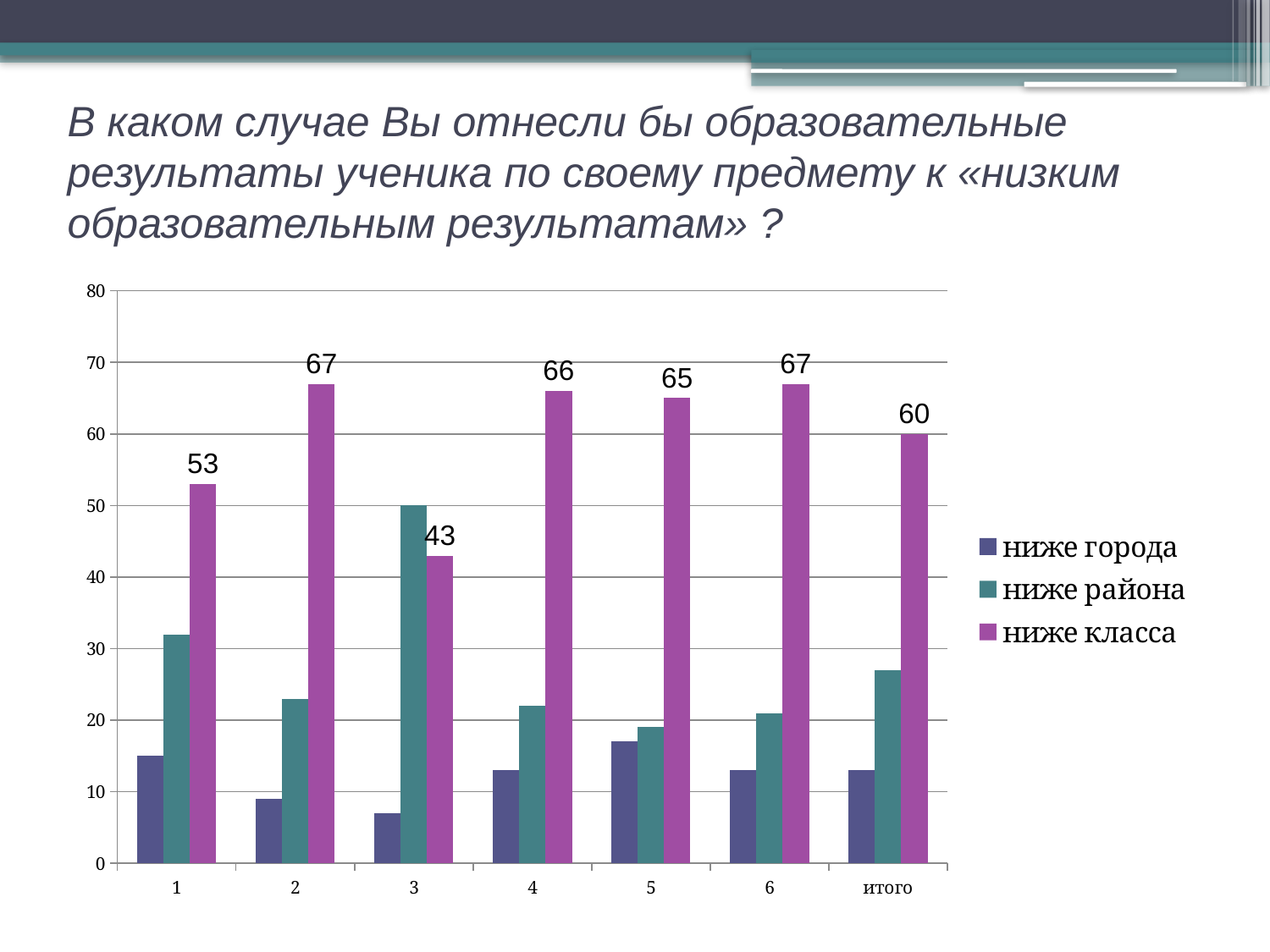
Which series is shown in purple? ниже класса What is the value of "ниже класса" for "итого"? 60 How many series does the legend list? 3 Which is larger: the "ниже класса" value for category 1 or for category 4? category 4 What is the difference between the "ниже класса" values for category 2 and category 3? 24 Is the value of "ниже района" for category 3 greater or less than 40? greater Is the value of "ниже города" for category 2 greater or less than 10? less Which category has the lowest value for "ниже класса"? 3 What is the value of "ниже класса" for category 1? 53 What kind of chart is shown on the slide? bar chart How many categories are shown on the x axis? 7 What is the value of "ниже класса" for category 3? 43